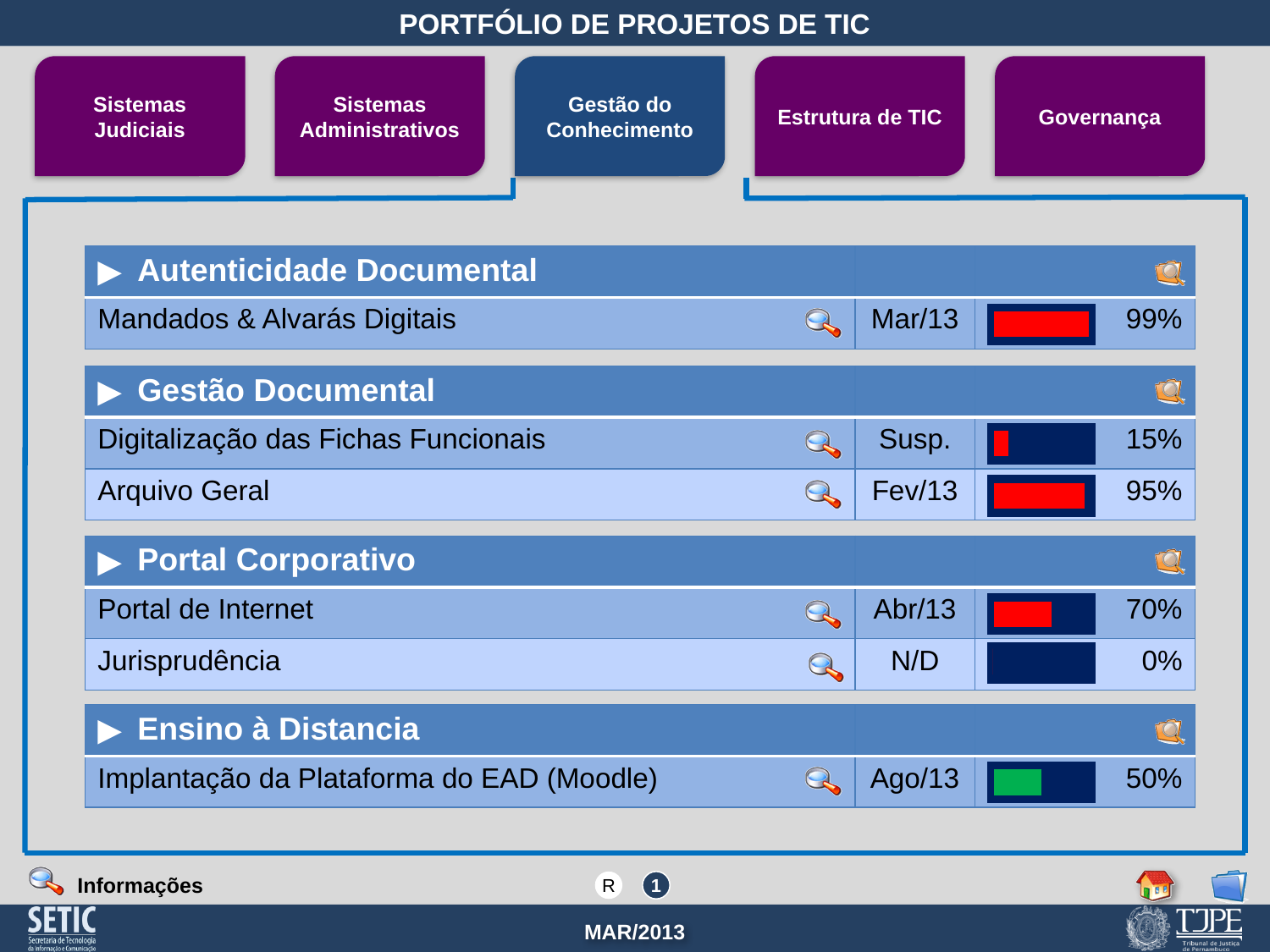
What completion percentage is shown for Digitalização das Fichas Funcionais? 15% How many project groups (section headers) are listed on the slide? 4 What date is shown next to Portal de Internet? Abr/13 How many projects have a progress bar on the slide? 6 What completion percentage is shown for Implantação da Plataforma do EAD (Moodle)? 50% Which project has the lowest completion percentage? Jurisprudência Which project has the highest completion percentage? Mandados & Alvarás Digitais What is the difference in completion percentage between Arquivo Geral and Portal de Internet? 25% What status is shown in the date column for Digitalização das Fichas Funcionais? Susp. Which has a higher completion percentage, Portal de Internet or Implantação da Plataforma do EAD (Moodle)? Portal de Internet What completion percentage is shown for Mandados & Alvarás Digitais? 99% What colour is the progress bar fill for Implantação da Plataforma do EAD (Moodle)? Green